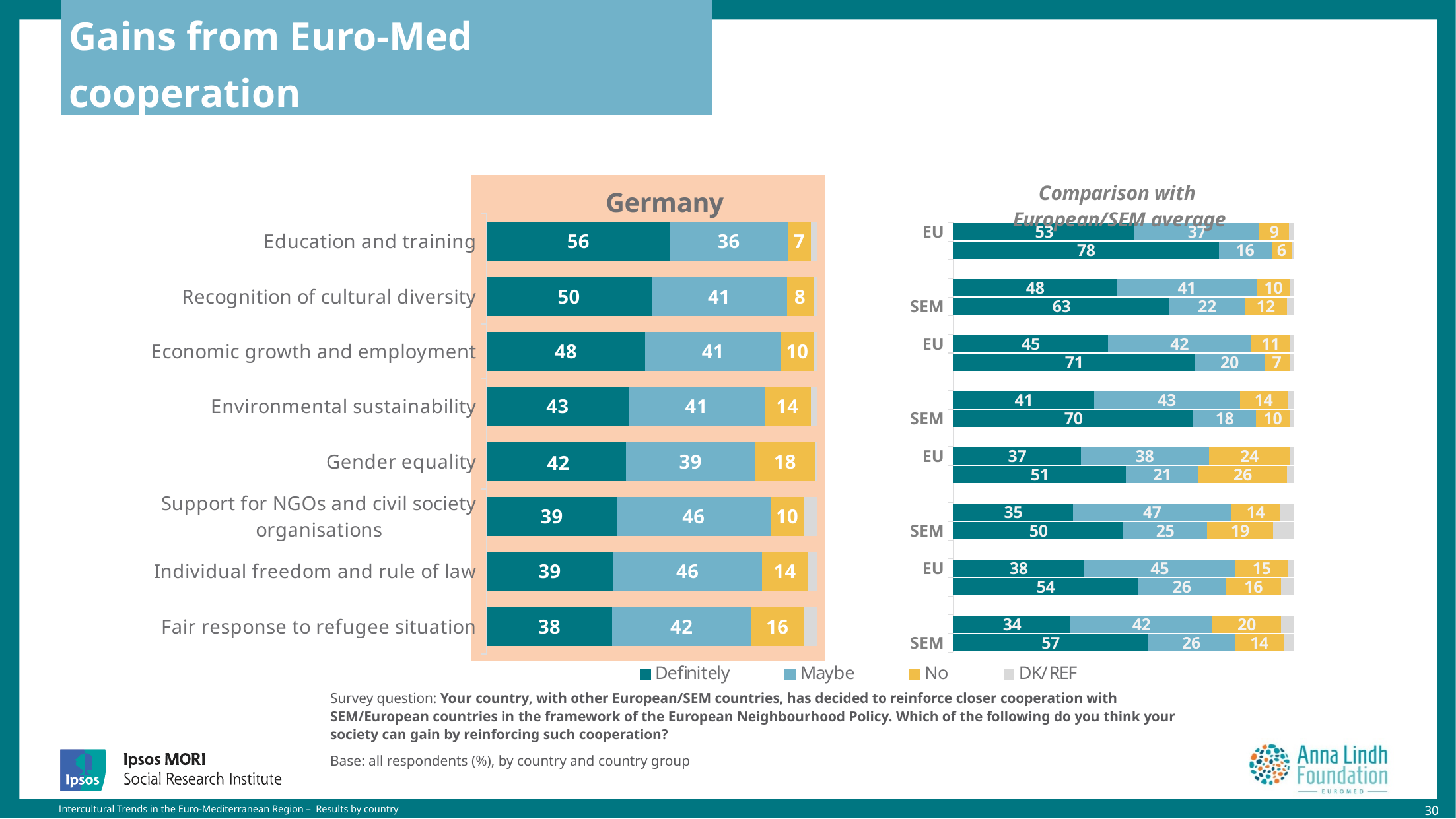
In the Germany chart, what is the total of the Definitely, Maybe and No values for Education and training? 99 In the Germany chart, which has the larger Maybe value: Support for NGOs and civil society organisations or Gender equality? Support for NGOs and civil society organisations In the Germany chart, what is the No value for Gender equality? 18 In the Germany chart, what is the Maybe value for Fair response to refugee situation? 42 How many categories are shown in the Germany chart? 8 In the Germany chart, what is the difference between the Definitely values for Education and training and Fair response to refugee situation? 18 In the Germany chart, which category has the lowest Definitely value? Fair response to refugee situation In the Comparison with European/SEM average chart, what is the Definitely value in the very first (top) EU bar? 53 In the Germany chart, what is the Definitely value for Education and training? 56 What kind of chart is the Germany chart? Stacked bar chart In the Germany chart, which category has the highest Definitely value? Education and training How many series does the legend list? 4